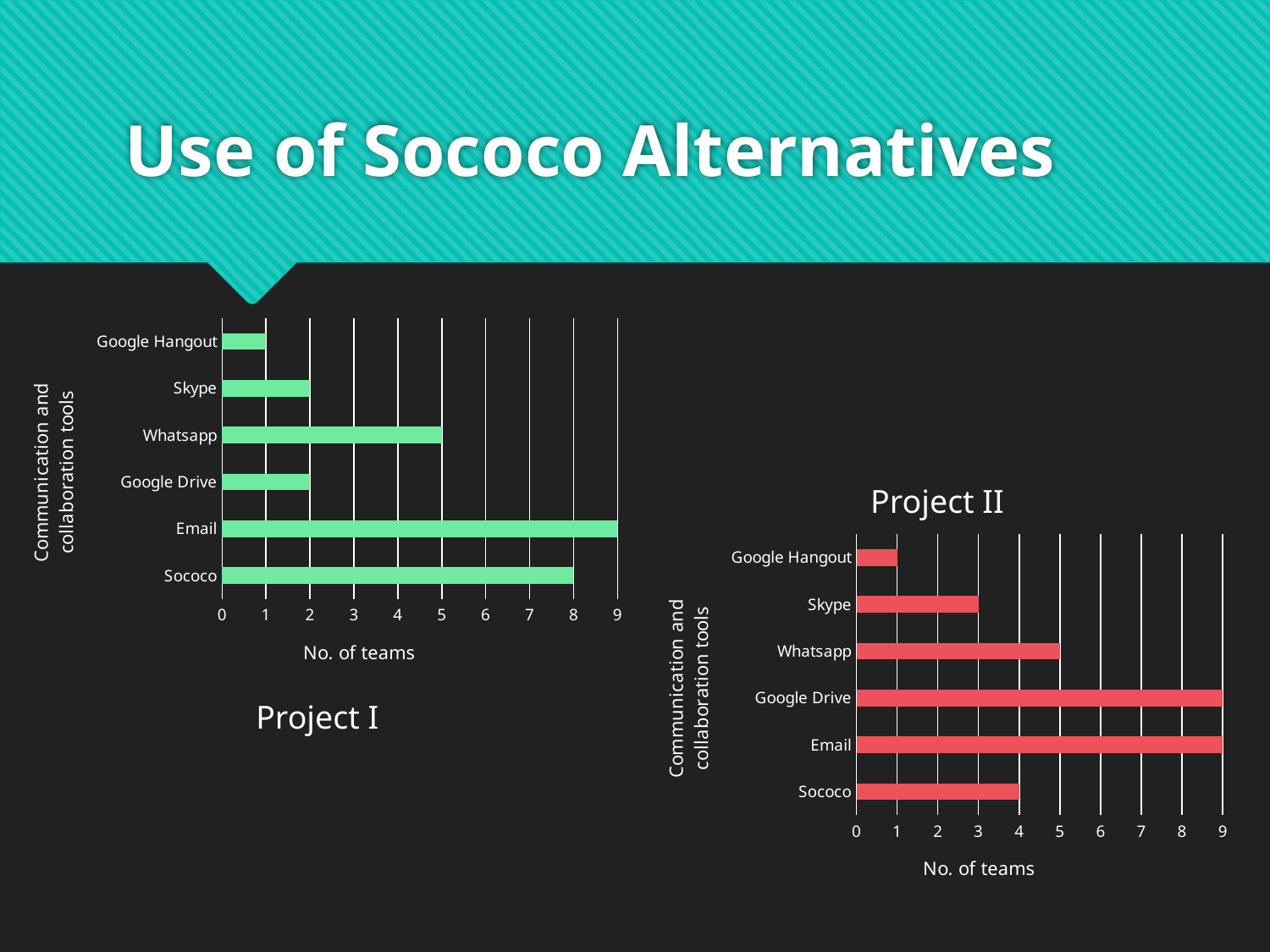
In the Project I chart, how many teams used Email? 9 In the Project I chart, what is the difference in number of teams between Whatsapp and Skype? 3 How many tools are listed in the Project I chart? 6 In the Project I chart, which tool has the lowest number of teams? Google Hangout In the Project II chart, which has more teams, Google Drive or Whatsapp? Google Drive In the Project II chart, which tool has the lowest number of teams? Google Hangout In the Project II chart, is the value for Email greater or less than 5? greater What type of chart is the Project II chart? Bar chart In the Project II chart, how many teams used Skype? 3 In the Project I chart, which tool has the highest number of teams? Email In the Project II chart, how many teams used Sococo? 4 In the Project I chart, how many teams used Sococo? 8